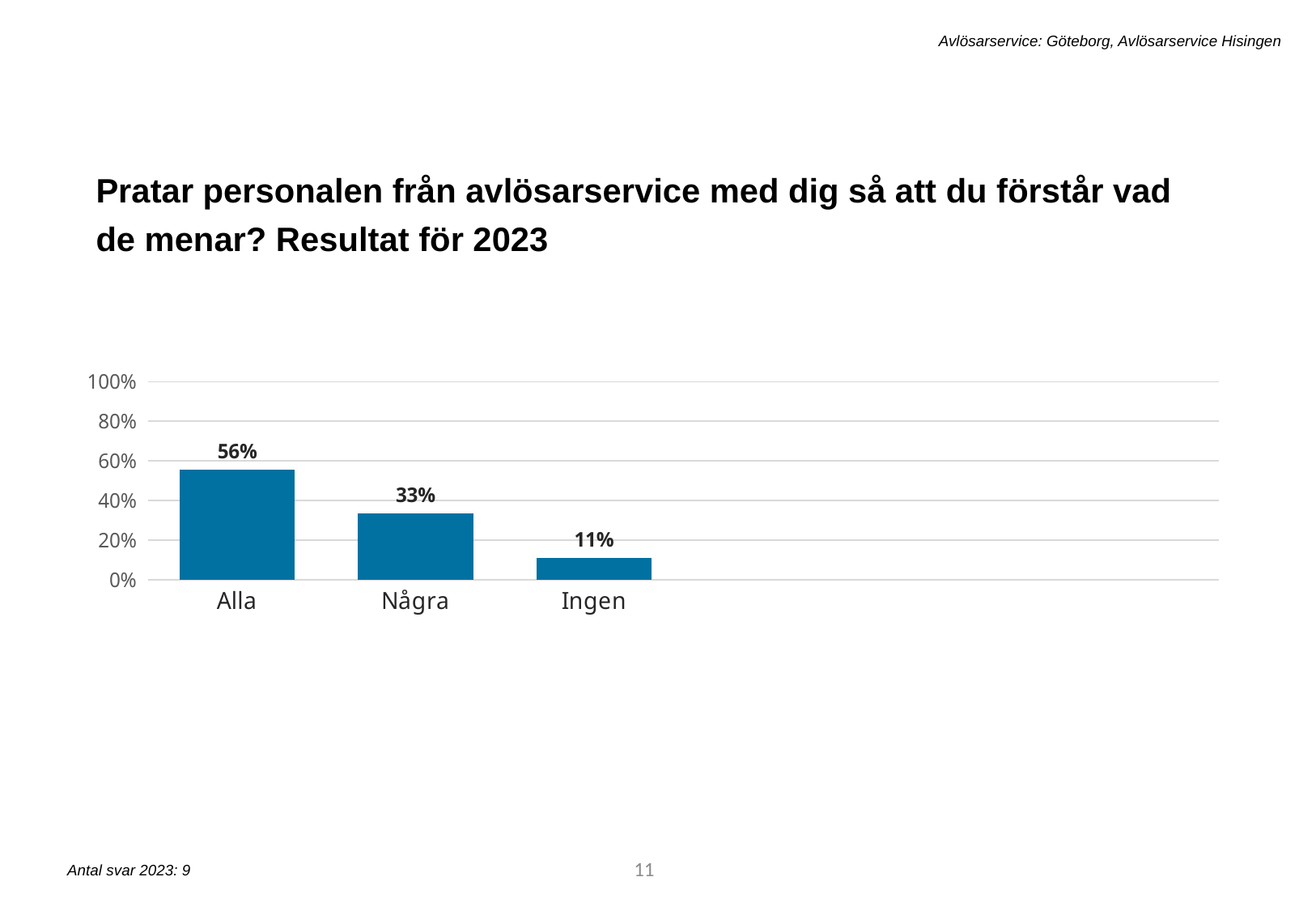
Which category has the lowest value? Ingen What is the value for Några? 33% What kind of chart is shown on the slide? bar chart What is the difference between the values for Alla and Några? 23% How many categories are shown on the x axis? 3 Do the values rise or fall from left to right along the x axis? fall What is the value for Ingen? 11% What is the value for Alla? 56% What is the difference between the values for Några and Ingen? 22% Which is larger, the value for Några or the value for Ingen? Några Is the value for Alla greater or less than 40%? greater Which category has the highest value? Alla